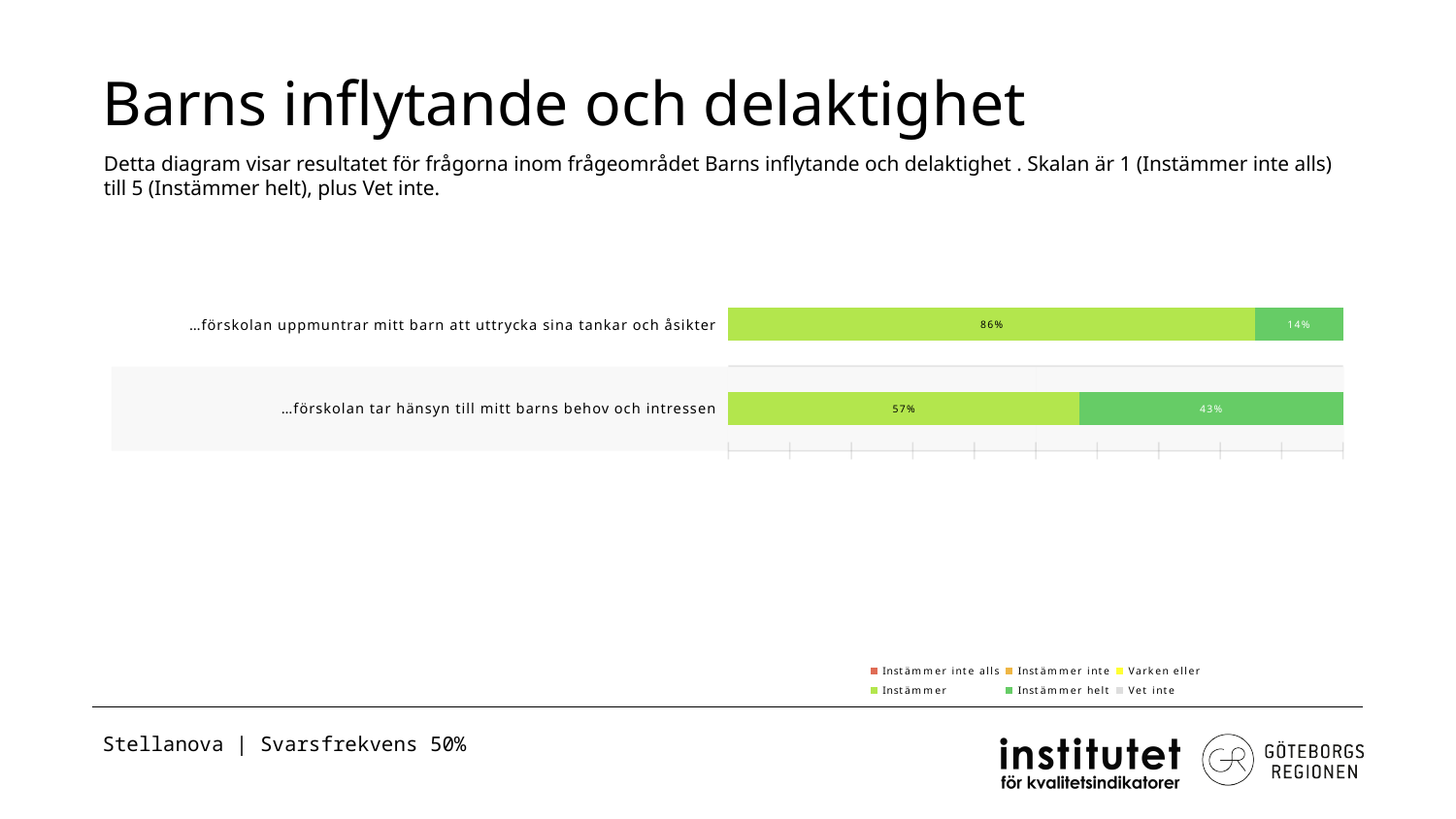
What is the total of the stacked bar for "…förskolan tar hänsyn till mitt barns behov och intressen"? 100% What is the "Instämmer" value for "…förskolan tar hänsyn till mitt barns behov och intressen"? 57% What is the "Instämmer" value for "…förskolan uppmuntrar mitt barn att uttrycka sina tankar och åsikter"? 86% How many categories (questions) are plotted in the chart? 2 How many series does the legend list? 6 What is the difference between the "Instämmer" values of the two categories? 29% Which category has the higher "Instämmer" value? …förskolan uppmuntrar mitt barn att uttrycka sina tankar och åsikter What is the "Instämmer helt" value for "…förskolan tar hänsyn till mitt barns behov och intressen"? 43% What is the "Instämmer helt" value for "…förskolan uppmuntrar mitt barn att uttrycka sina tankar och åsikter"? 14% Is the "Instämmer helt" value larger for "…förskolan tar hänsyn till mitt barns behov och intressen" or for "…förskolan uppmuntrar mitt barn att uttrycka sina tankar och åsikter"? …förskolan tar hänsyn till mitt barns behov och intressen Which category has the lower "Instämmer helt" value? …förskolan uppmuntrar mitt barn att uttrycka sina tankar och åsikter What kind of chart is shown on the slide? stacked bar chart